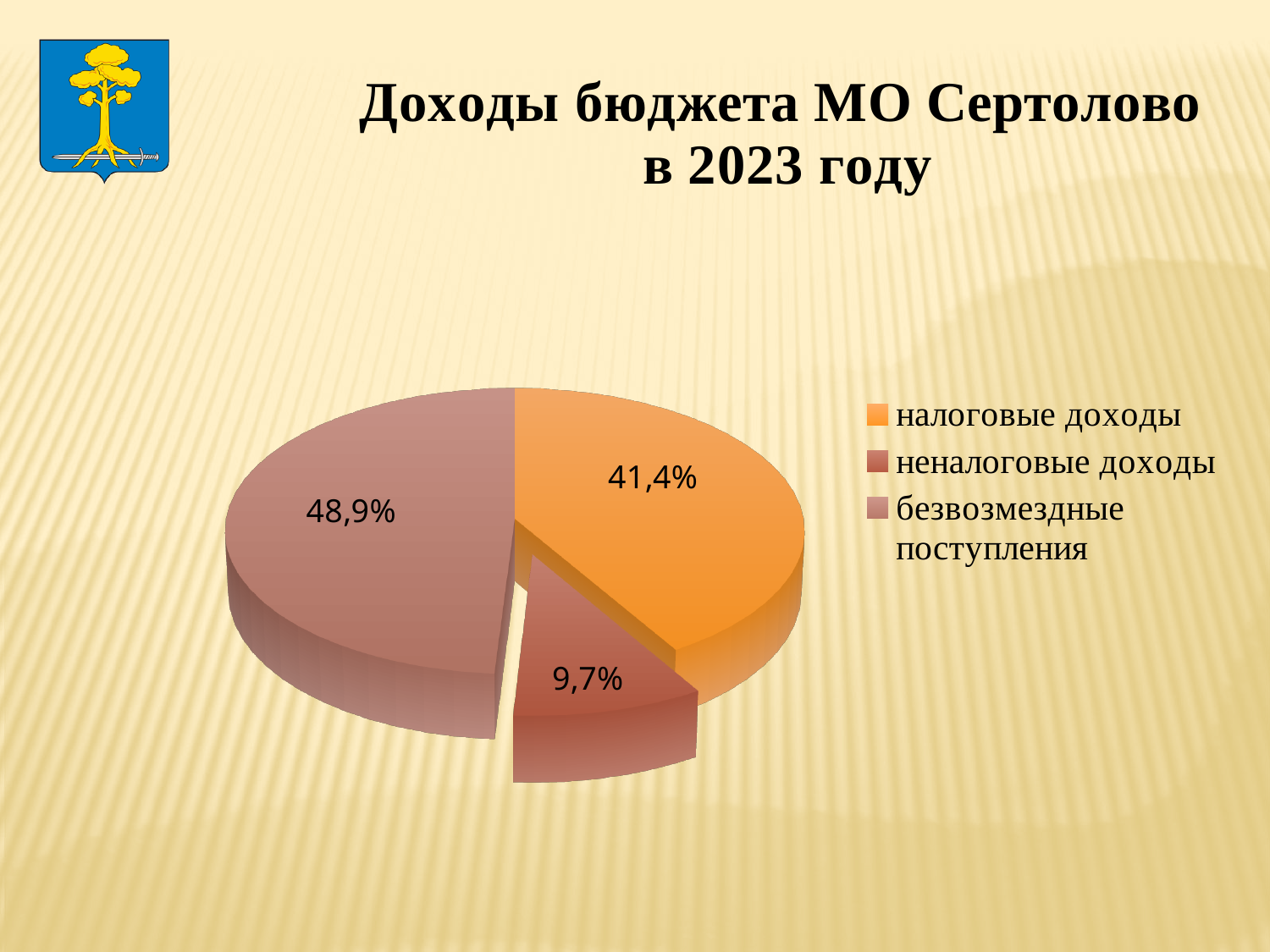
Which is larger, the share for налоговые доходы or the share for неналоговые доходы? налоговые доходы What is the difference in percentage points between безвозмездные поступления and налоговые доходы? 7,5 What is the title of the slide containing the chart? Доходы бюджета МО Сертолово в 2023 году Which category has the smallest slice of the pie? неналоговые доходы How many entries does the legend list? 3 What share of the pie is labelled for налоговые доходы? 41,4% Which category has the largest slice of the pie? безвозмездные поступления What share of the pie is labelled for безвозмездные поступления? 48,9% How many slices does the pie chart have? 3 What is the difference in percentage points between налоговые доходы and неналоговые доходы? 31,7 What kind of chart is shown on the slide? pie chart What share of the pie is labelled for неналоговые доходы? 9,7%